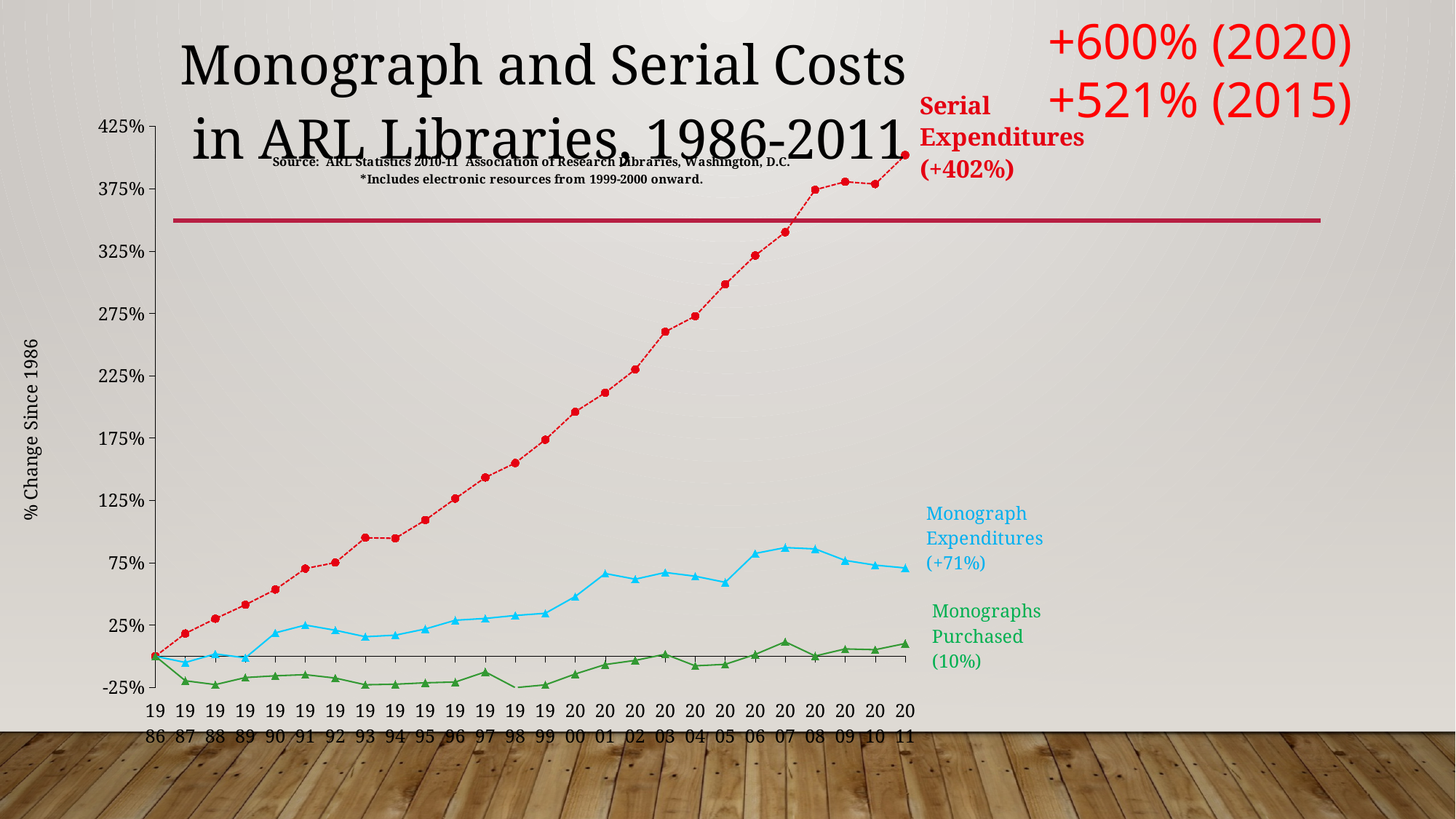
What is the label on the vertical axis? % Change Since 1986 Is the value for Serial Expenditures in 2005 greater or less than 275%? greater What type of chart is shown on the slide? Line chart How many years are shown along the x axis? 26 How many data series are plotted on the chart? 3 What is the percent change for Serial Expenditures by 2011, as labelled on the chart? +402% What is the percent change for Monograph Expenditures by 2011, as labelled on the chart? +71% What is the title of the chart? Monograph and Serial Costs in ARL Libraries, 1986-2011 What is the percent change for Monographs Purchased by 2011, as labelled on the chart? 10% What is the difference between the labelled 2011 values for Serial Expenditures and Monograph Expenditures? 331 percentage points Which series has the highest value in 2011? Serial Expenditures Does the Serial Expenditures series generally rise or fall from 1986 to 2011? Rise